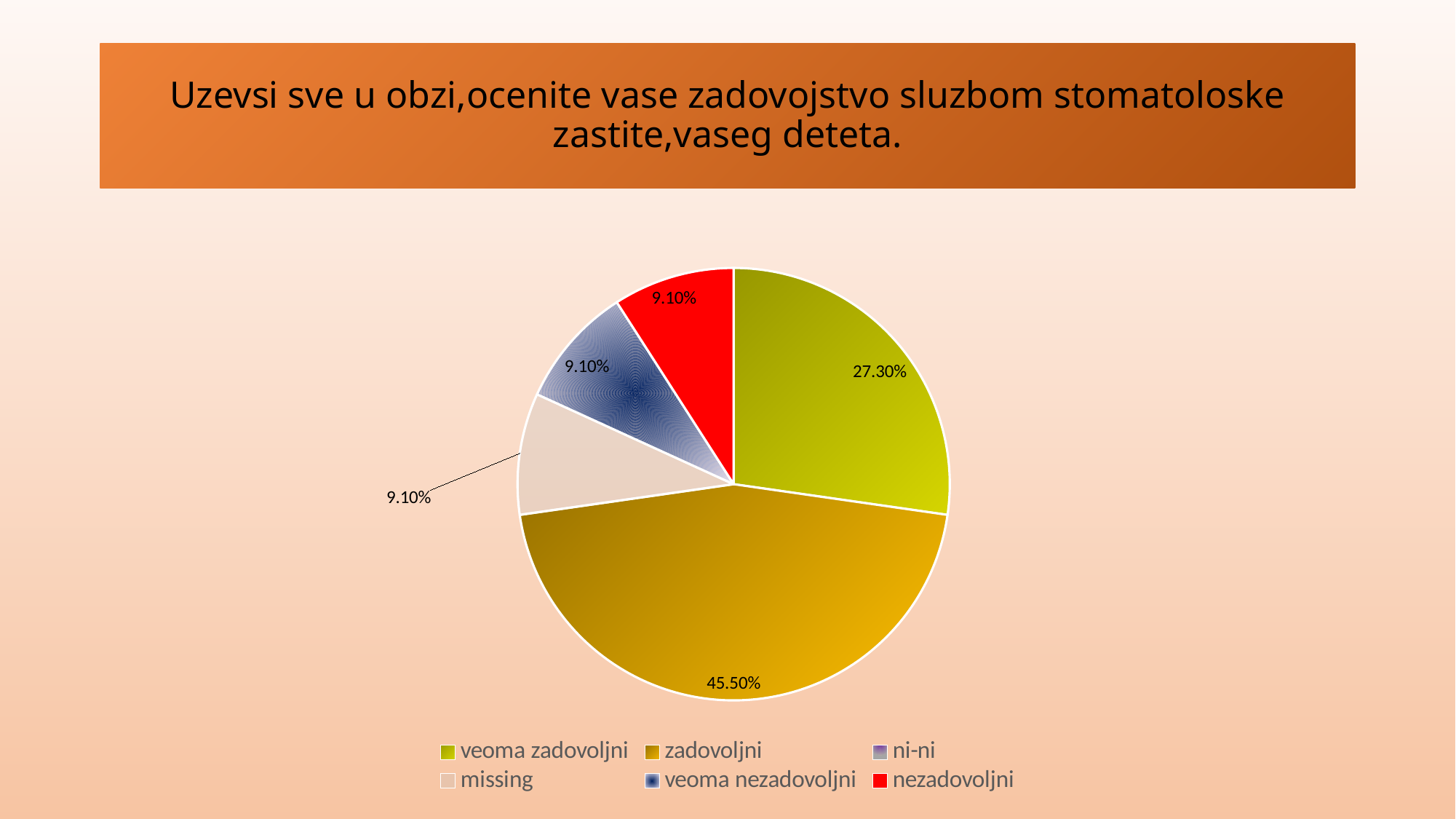
What percentage is shown for the 'missing' slice? 9.10% What colour is the 'nezadovoljni' slice? red Which slice is larger, 'veoma zadovoljni' or 'nezadovoljni'? veoma zadovoljni How many entries does the legend list? 6 What percentage of the pie is labelled for the 'zadovoljni' slice? 45.50% How many slices with data labels are visible in the pie? 5 Is the share for 'zadovoljni' greater or less than 50%? less What percentage is shown for the 'nezadovoljni' slice? 9.10% What percentage is shown for the 'veoma zadovoljni' slice? 27.30% What kind of chart is shown on the slide? pie chart Which category has the largest slice of the pie? zadovoljni What is the difference in percentage points between the 'zadovoljni' and 'veoma zadovoljni' slices? 18.20%